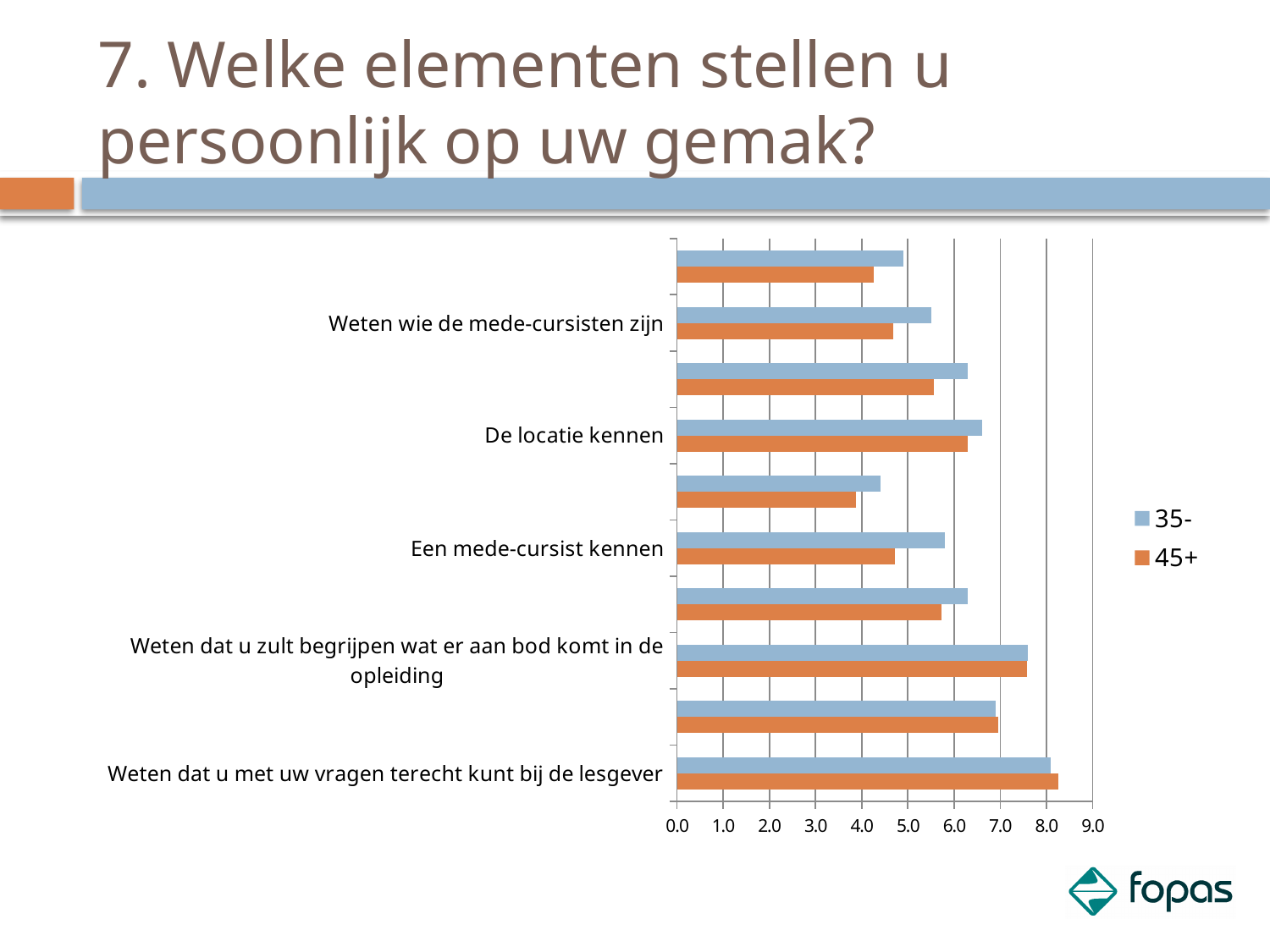
For 'Een mede-cursist kennen', which series has the larger value, 35- or 45+? 35- How many series does the legend list? 2 Is the 45+ value for 'Een mede-cursist kennen' greater or less than 5.0? less Is the 45+ value for 'Weten wie de mede-cursisten zijn' greater or less than 5.0? less Is the 45+ value for 'Weten dat u met uw vragen terecht kunt bij de lesgever' greater or less than 8.0? greater Which labelled category has the highest value for the 35- series? Weten dat u met uw vragen terecht kunt bij de lesgever What kind of chart is shown on the slide? bar chart Which colour represents the 45+ series? orange What are the two series named in the legend? 35- and 45+